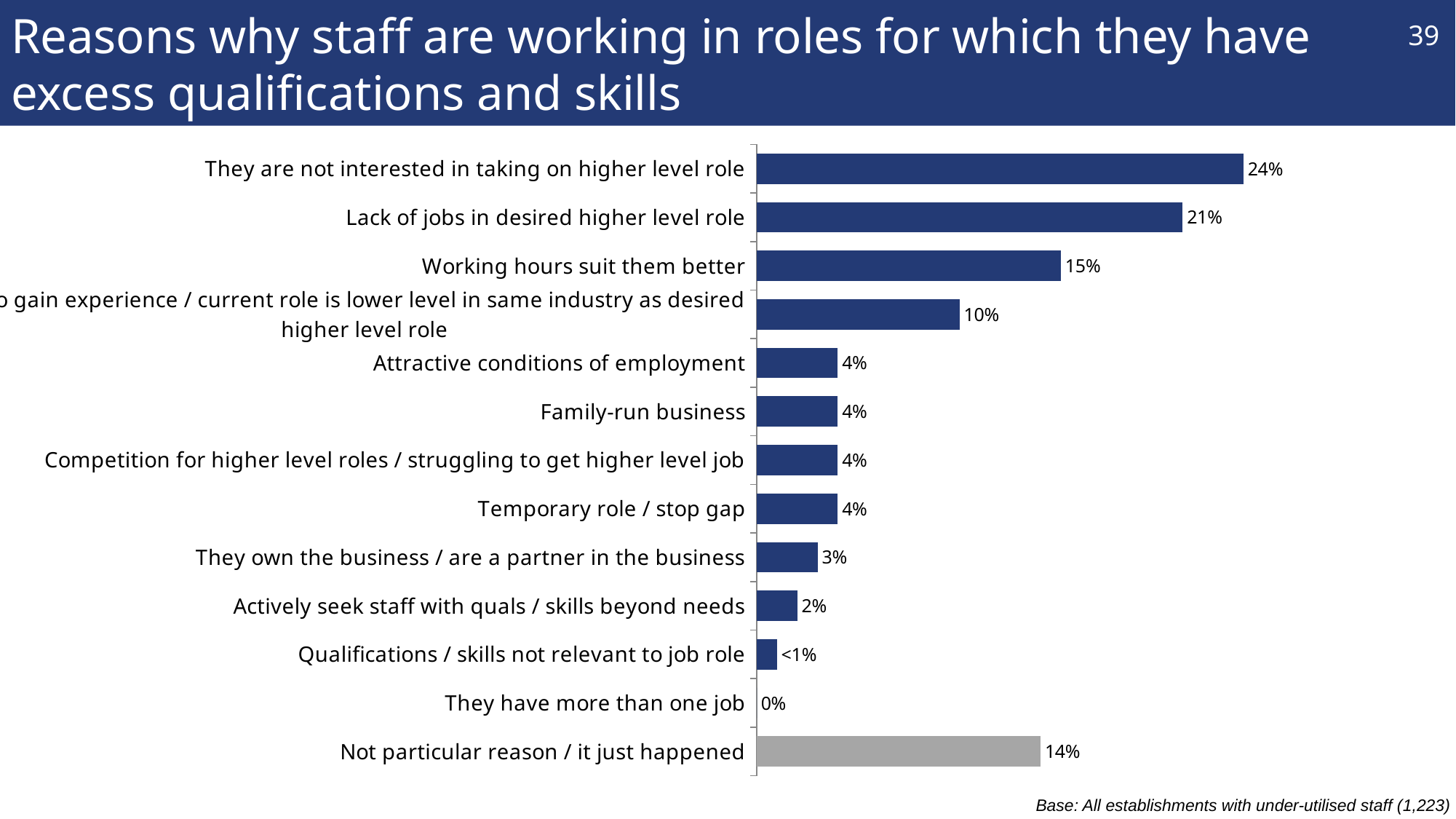
Which bar is shown in grey rather than dark blue? Not particular reason / it just happened What percentage is shown for 'They are not interested in taking on higher level role'? 24% What is the difference between 'They are not interested in taking on higher level role' and 'Lack of jobs in desired higher level role'? 3 percentage points Which reason has the highest percentage? They are not interested in taking on higher level role What type of chart is shown on the slide? Bar chart How many reasons (categories) are shown in the chart? 13 What value is shown for 'Not particular reason / it just happened'? 14% Which is larger: 'Working hours suit them better' or 'Not particular reason / it just happened'? Working hours suit them better What value is shown for 'Qualifications / skills not relevant to job role'? <1% What value is shown for 'Lack of jobs in desired higher level role'? 21% Which reason has the lowest percentage? They have more than one job What percentage is shown for 'Working hours suit them better'? 15%